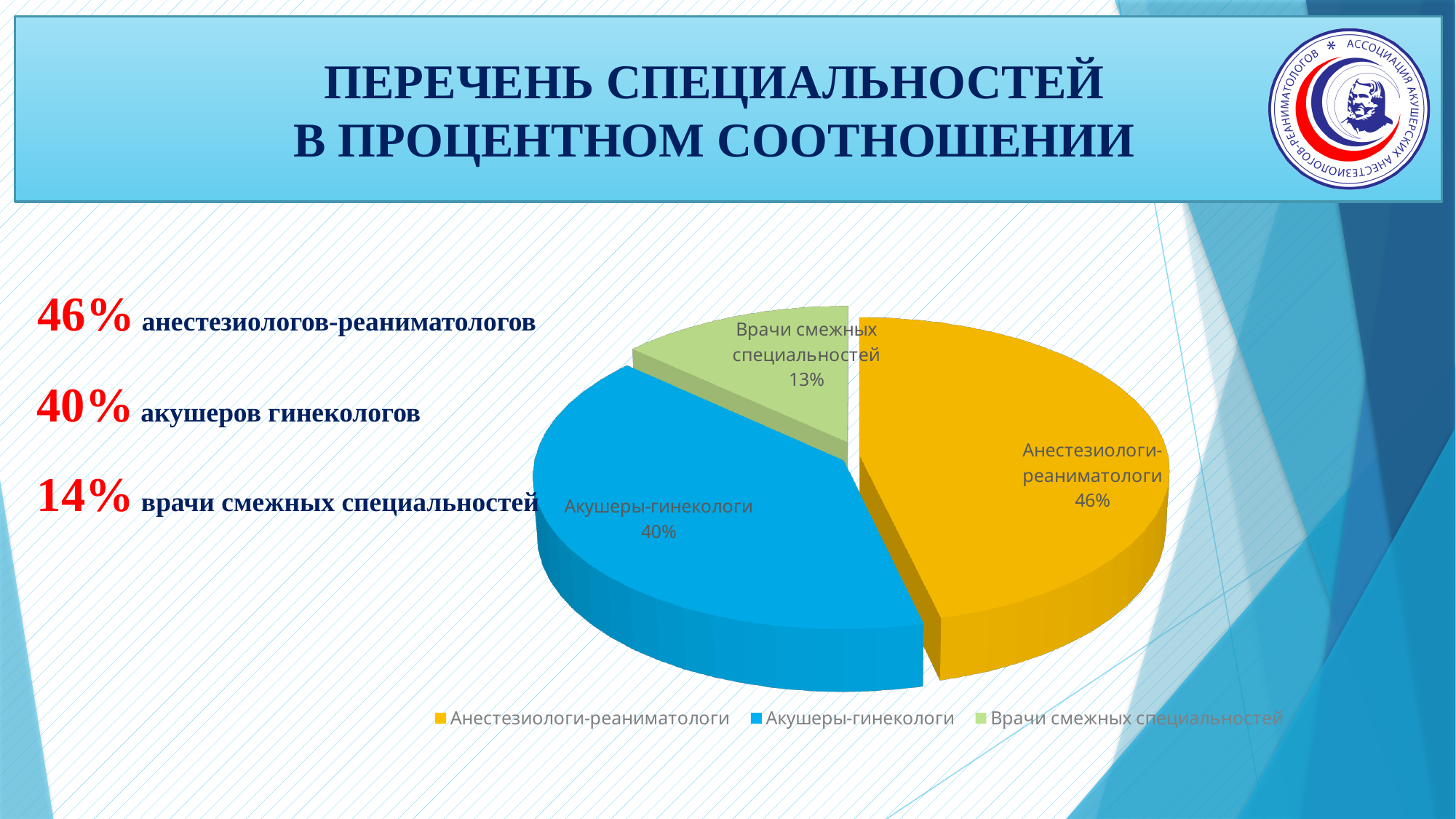
How many entries does the chart legend list? 3 What percentage does the chart show for Анестезиологи-реаниматологи? 46% Which category has the largest slice in the pie chart? Анестезиологи-реаниматологи What is the difference in percentage points between Анестезиологи-реаниматологи and Акушеры-гинекологи? 6 What is the difference in percentage points between Акушеры-гинекологи and Врачи смежных специальностей? 27 What percentage does the chart show for Акушеры-гинекологи? 40% How many slices does the pie chart have? 3 What kind of chart is shown on the slide? Pie chart Which slice is larger: Акушеры-гинекологи or Врачи смежных специальностей? Акушеры-гинекологи Which category has the smallest slice in the pie chart? Врачи смежных специальностей What percentage does the chart show for Врачи смежных специальностей? 13% What colour is the slice for Акушеры-гинекологи? Blue